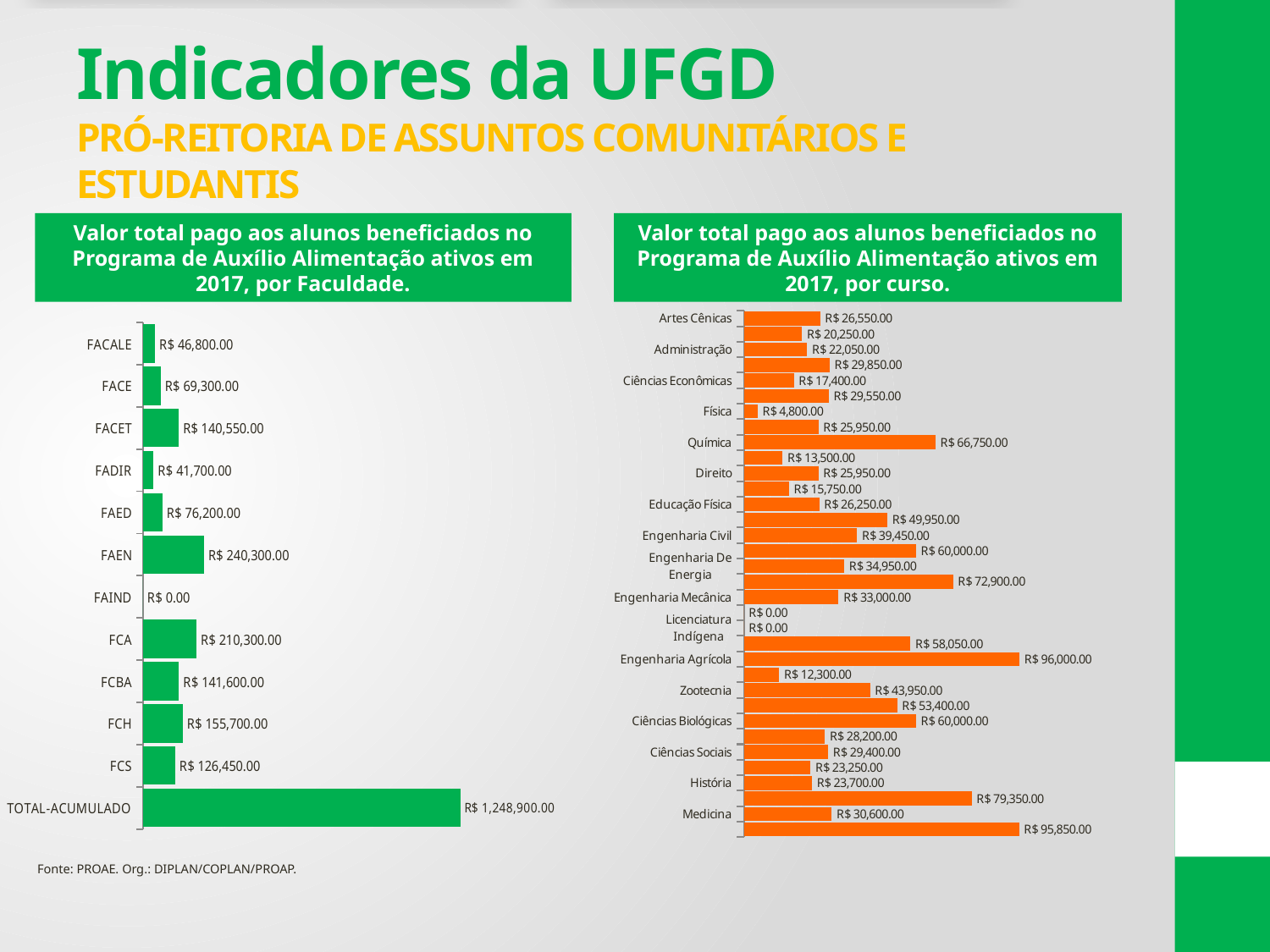
In the chart 'por Faculdade' on the left, which is larger, the value for FCBA or the value for FACET? FCBA In the chart 'por Faculdade' on the left, which faculty has the lowest value? FAIND What type of chart is the chart 'por Faculdade' on the left? Bar chart In the chart 'por Faculdade' on the left, which faculty (excluding TOTAL-ACUMULADO) has the highest value? FAEN In the chart 'por Faculdade' on the left, what is the value for FADIR? R$ 41,700.00 In the chart 'por Faculdade' on the left, what is the value for TOTAL-ACUMULADO? R$ 1,248,900.00 How many bars are shown in the chart 'por Faculdade' on the left? 12 In the chart 'por Faculdade' on the left, what is the value for FAEN? R$ 240,300.00 In the chart 'por Faculdade' on the left, what is the value for FCH? R$ 155,700.00 In the chart 'por Faculdade' on the left, what is the difference between the values for FCA and FACET? R$ 69,750.00 In the chart 'por curso' on the right, what is the largest value shown? R$ 96,000.00 In the chart 'por Faculdade' on the left, what is the difference between the values for FAED and FACE? R$ 6,900.00